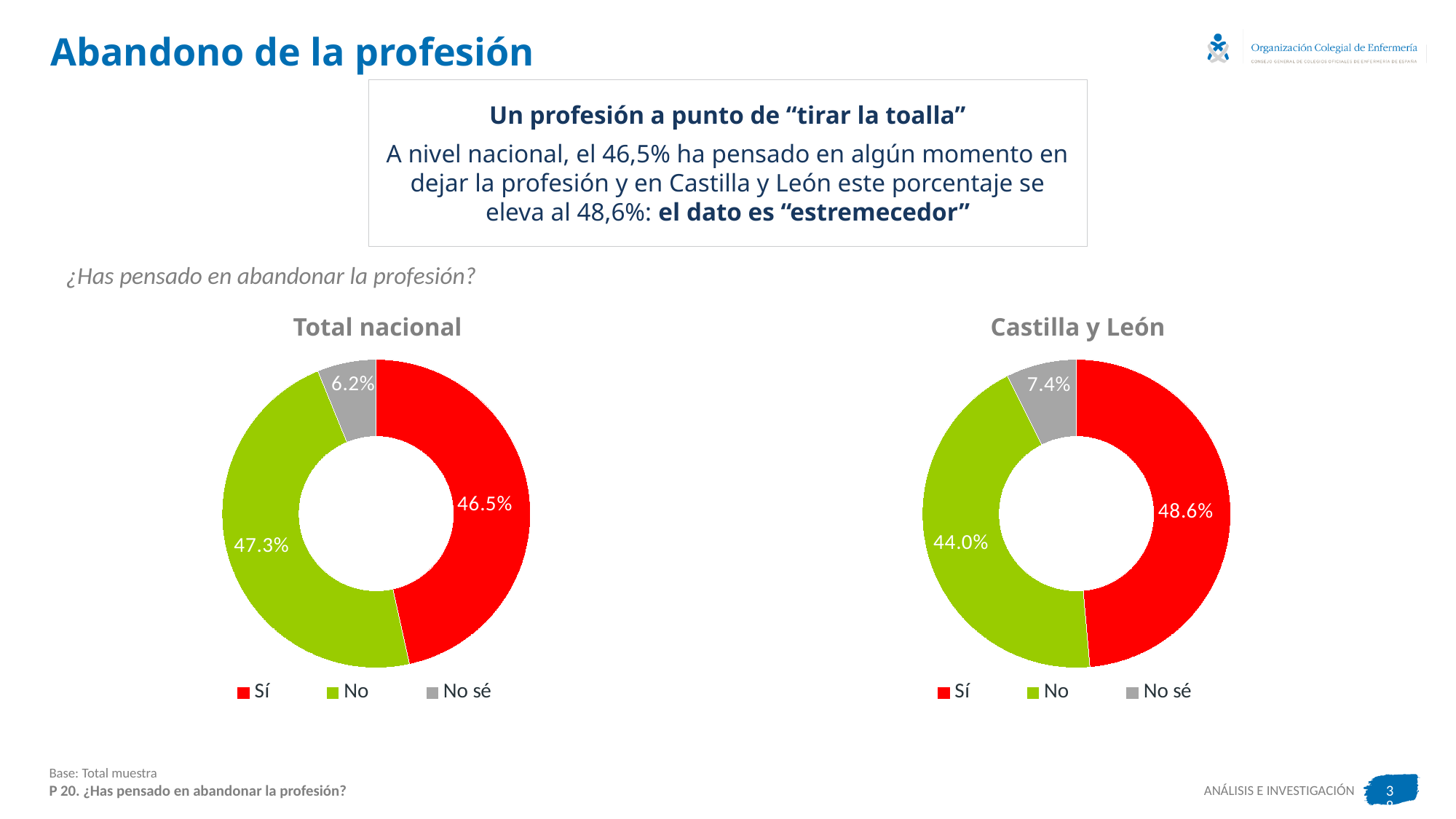
In the "Castilla y León" chart, what is the difference between the "Sí" and "No" values? 4.6% In the "Total nacional" chart, which category has the smallest share? No sé What kind of chart is the "Castilla y León" chart? Doughnut chart In the "Total nacional" chart, what is the difference between the "No" and "No sé" values? 41.1% Is the "Sí" value larger in the "Total nacional" chart or in the "Castilla y León" chart? Castilla y León What colour represents "No" in the "Total nacional" chart? Green What are the legend entries of the "Castilla y León" chart? Sí, No, No sé How many categories does the "Total nacional" chart show? 3 In the "Castilla y León" chart, what is the value for "No sé"? 7.4% In the "Castilla y León" chart, what is the value for "No"? 44.0% In the "Total nacional" chart, what is the value for "Sí"? 46.5% In the "Castilla y León" chart, which category has the largest share? Sí